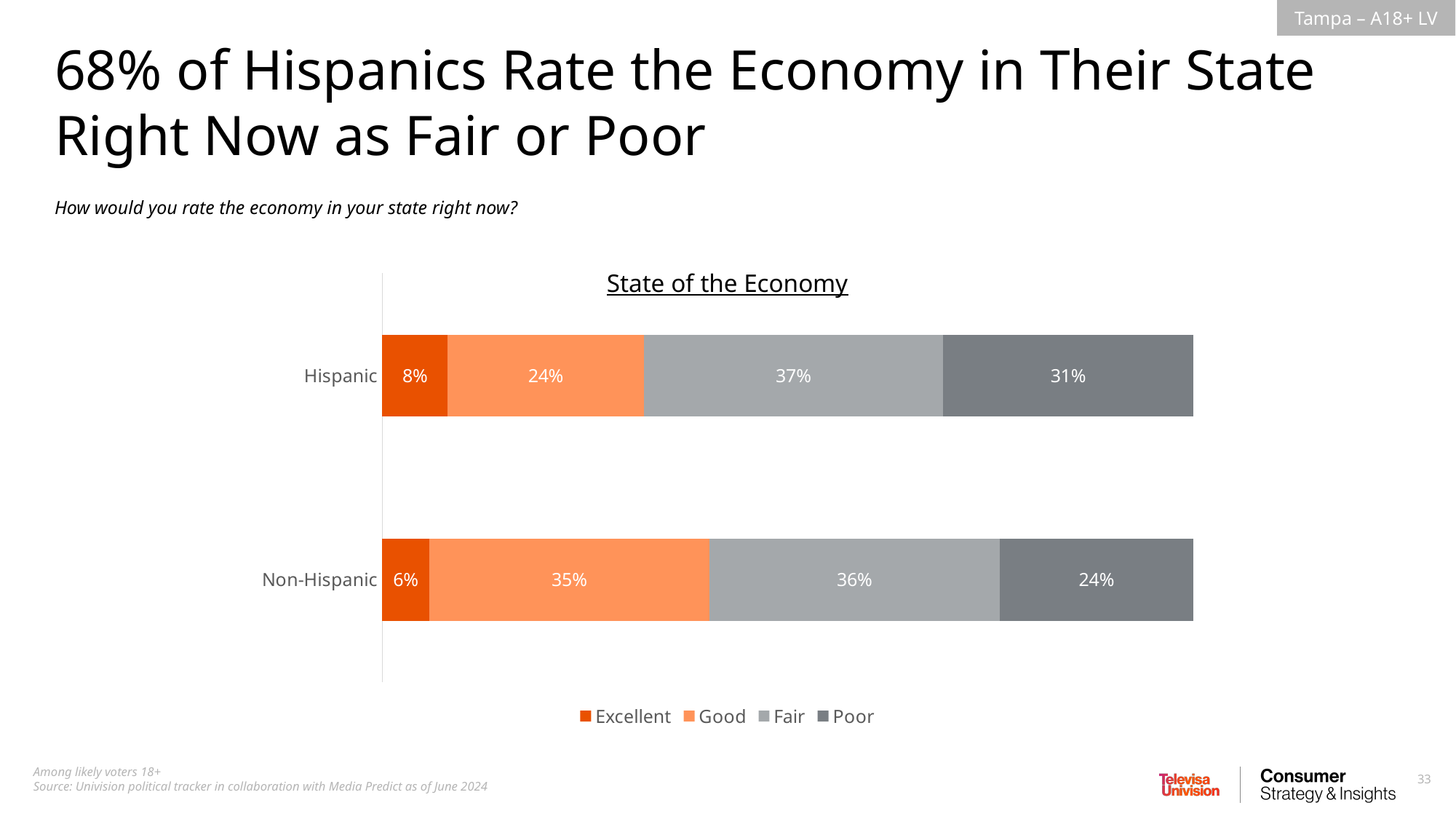
Which group has a larger Poor share, Hispanic or Non-Hispanic? Hispanic What percentage of Non-Hispanic respondents rate the economy as Excellent? 6% Which rating category has the largest share among Hispanic respondents? Fair What is the combined Fair and Poor share for Hispanic respondents? 68% What is the title of the chart? State of the Economy What percentage of Non-Hispanic respondents rate the economy in their state as Good? 35% What percentage of Hispanic respondents rate the economy as Poor? 31% What is the difference between the Good share for Non-Hispanic and Hispanic respondents? 11 percentage points How many series does the legend list? 4 What percentage of Hispanic respondents rate the economy in their state as Fair? 37% Which rating category has the smallest share among Non-Hispanic respondents? Excellent What kind of chart is shown on the slide? Stacked bar chart